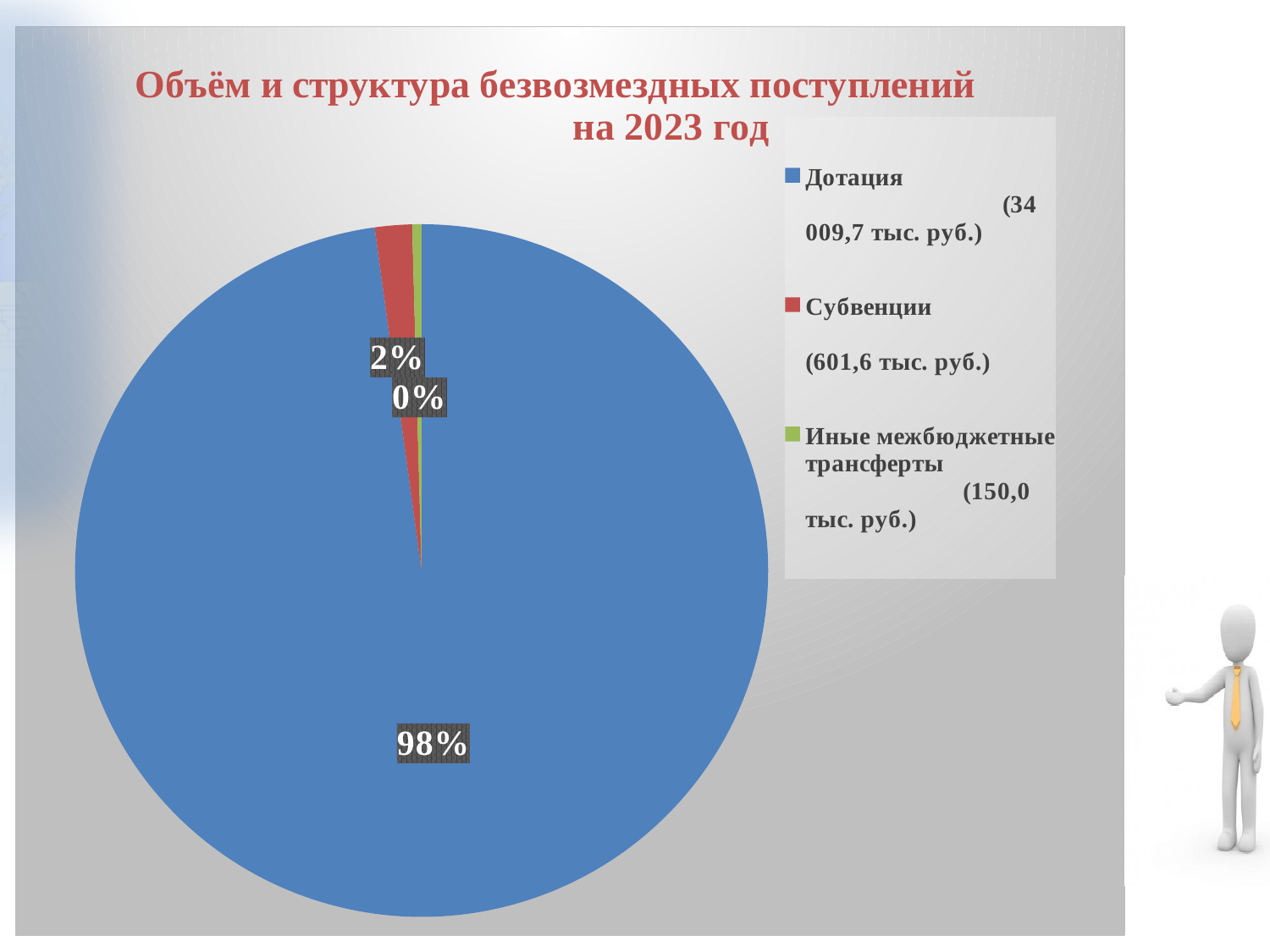
What is the amount shown in the legend for Иные межбюджетные трансферты? 150,0 тыс. руб. Which is larger, the amount for Субвенции or the amount for Иные межбюджетные трансферты? Субвенции What kind of chart is shown on the slide? pie chart Which category has the largest share of the pie? Дотация What share of the pie does Субвенции take? 2% Which category has the smallest share of the pie? Иные межбюджетные трансферты What is the amount shown in the legend for Дотация? 34 009,7 тыс. руб. What share of the pie does Дотация take? 98% How many categories does the legend list? 3 What is the title of the chart? Объём и структура безвозмездных поступлений на 2023 год What share of the pie does Иные межбюджетные трансферты take? 0% What is the amount shown in the legend for Субвенции? 601,6 тыс. руб.